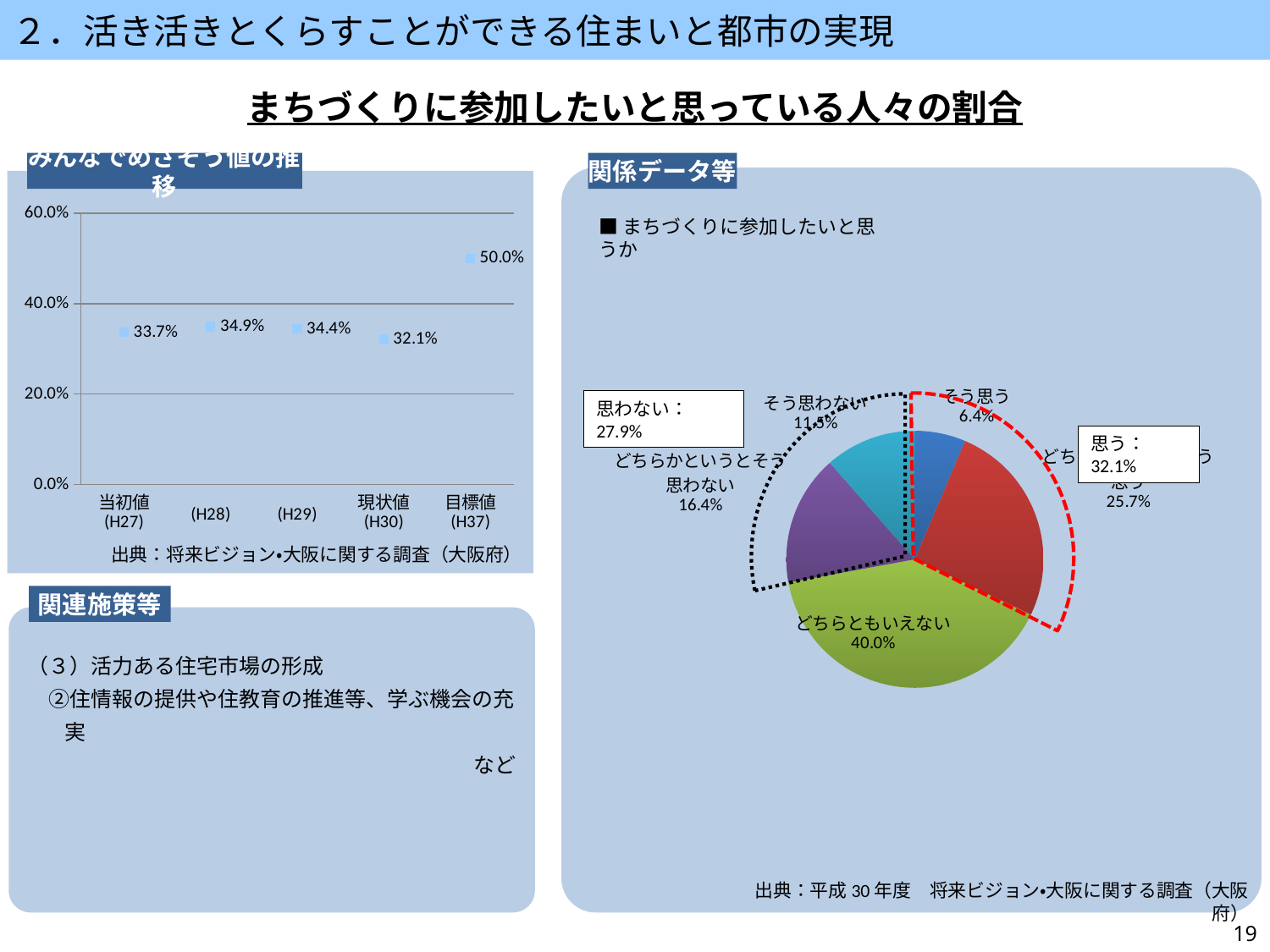
In the left chart (みんなでめざそう値の推移), what is the value for 現状値 (H30)? 32.1% In the left chart (みんなでめざそう値の推移), what is the difference between the 目標値 (H37) value and the 現状値 (H30) value? 17.9% In the left chart (みんなでめざそう値の推移), how many data points are plotted? 5 In the left chart (みんなでめざそう値の推移), which category has the lowest value? 現状値 (H30) In the left chart (みんなでめざそう値の推移), what is the value for 目標値 (H37)? 50.0% What kind of chart is shown on the right side of the slide? pie chart In the left chart (みんなでめざそう値の推移), is the value for H29 greater or less than 40.0%? less In the pie chart on the right (まちづくりに参加したいと思うか), what is the value for そう思う? 6.4% In the left chart (みんなでめざそう値の推移), which category has the highest value? 目標値 (H37) In the left chart (みんなでめざそう値の推移), what is the value for 当初値 (H27)? 33.7% In the pie chart on the right (まちづくりに参加したいと思うか), what share does どちらともいえない have? 40.0% In the pie chart on the right (まちづくりに参加したいと思うか), which slice is the largest? どちらともいえない